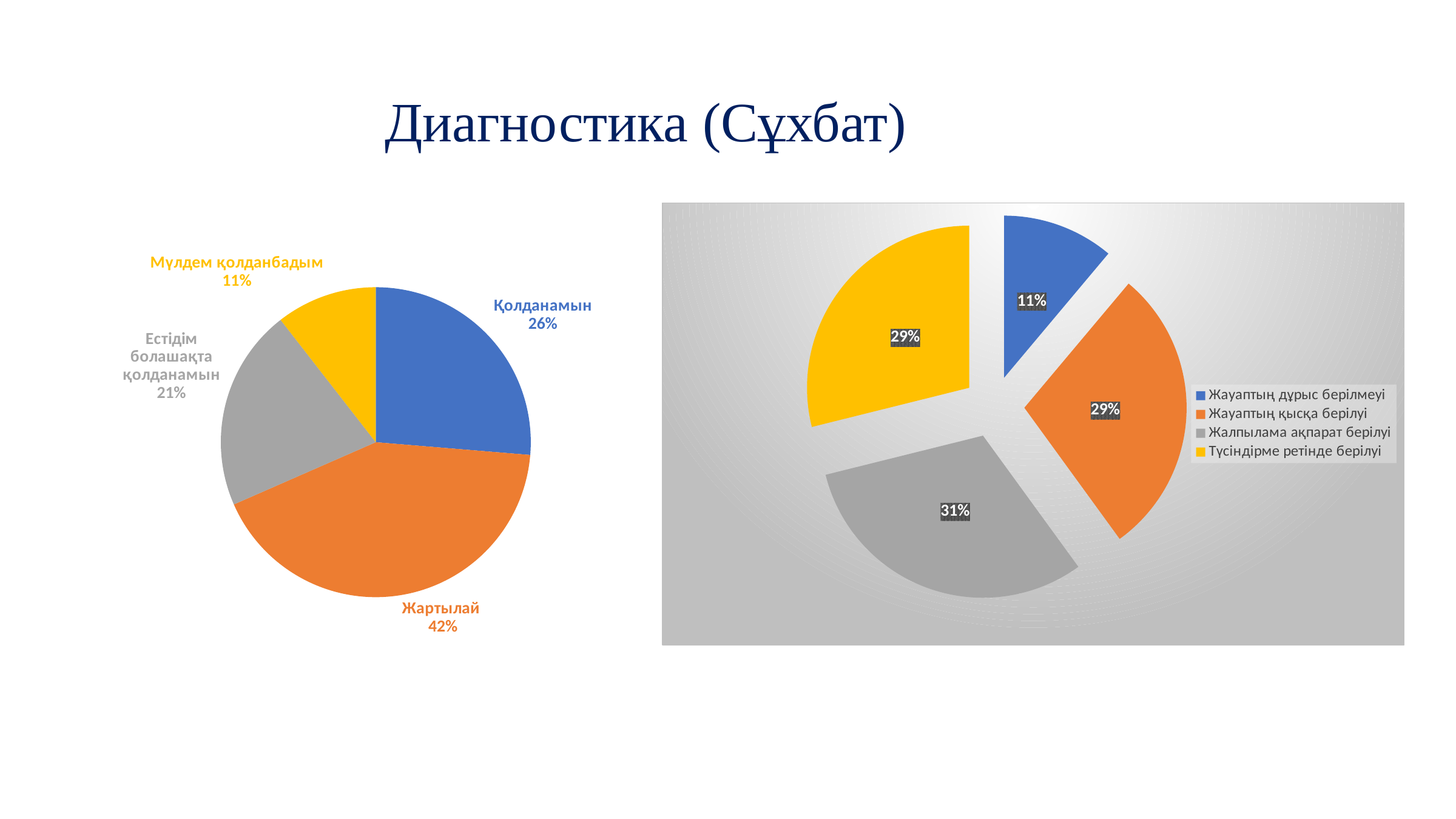
In the left pie chart, what is the share for Жартылай? 42% In the right pie chart, which is larger: Жауаптың қысқа берілуі or Жауаптың дұрыс берілмеуі? Жауаптың қысқа берілуі In the right pie chart, what is the share for Жалпылама ақпарат берілуі? 31% In the right pie chart, what is the share for Жауаптың дұрыс берілмеуі? 11% In the left pie chart, which category has the smallest share? Мүлдем қолданбадым How many entries does the legend of the right pie chart list? 4 How many slices does the left pie chart have? 4 In the left pie chart, which category has the largest share? Жартылай In the left pie chart, what is the difference between the shares for Жартылай and Естідім болашақта қолданамын? 21% In the right pie chart, which category has the largest share? Жалпылама ақпарат берілуі In the left pie chart, what is the share for Қолданамын? 26% What type of chart is the left chart on the slide? Pie chart